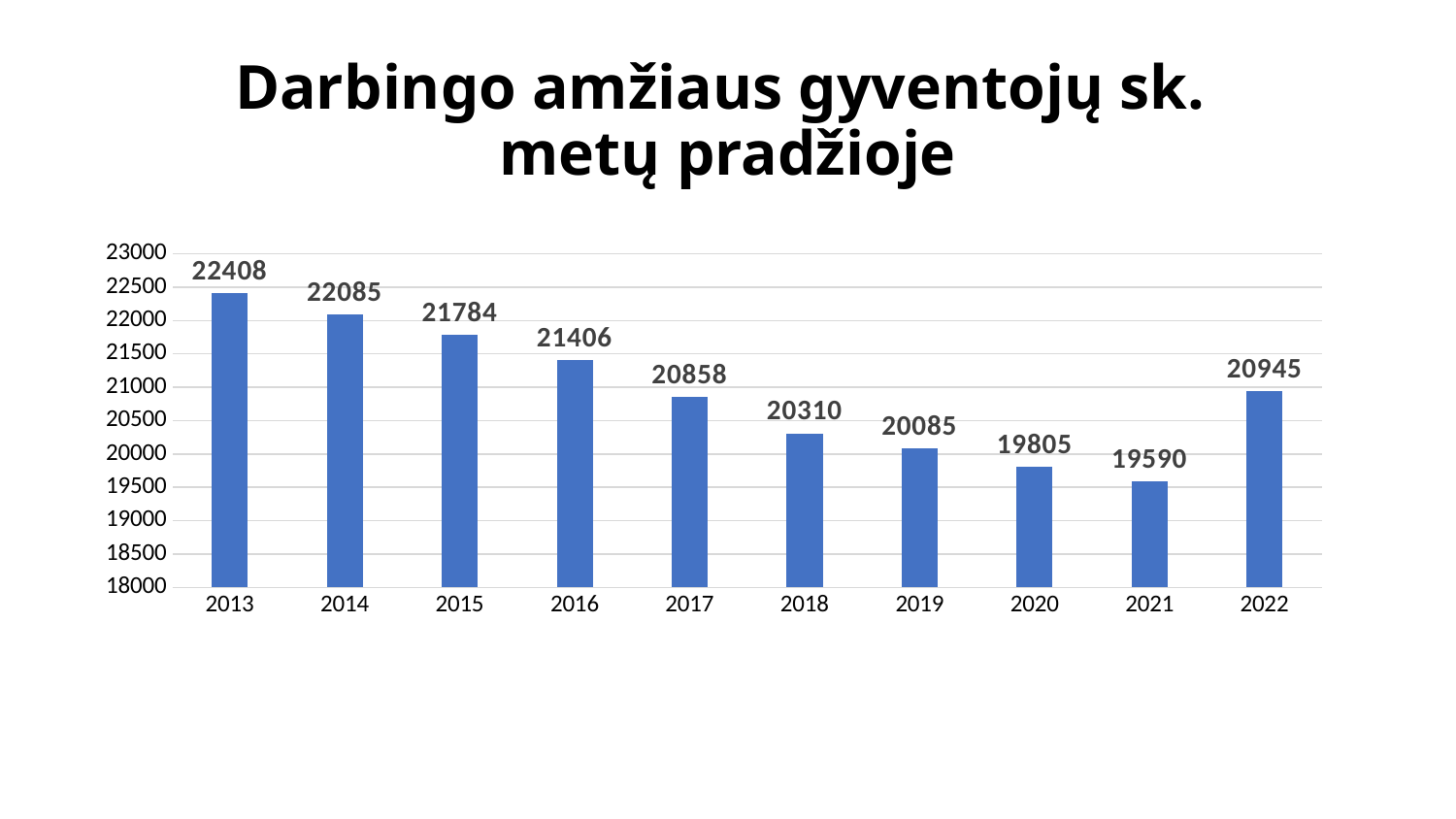
Is the value for 2020 greater or less than 20000? less What kind of chart is this? bar chart What is the value for 2018? 20310 What is the difference between the values for 2013 and 2021? 2818 Which year has the lowest value? 2021 How many years are shown on the x axis? 10 What is the value for 2013? 22408 What is the value for 2022? 20945 Do the values rise or fall from 2013 to 2021? fall Which is larger, the value for 2017 or the value for 2022? 2022 Which year has the highest value? 2013 What is the difference between the values for 2022 and 2021? 1355